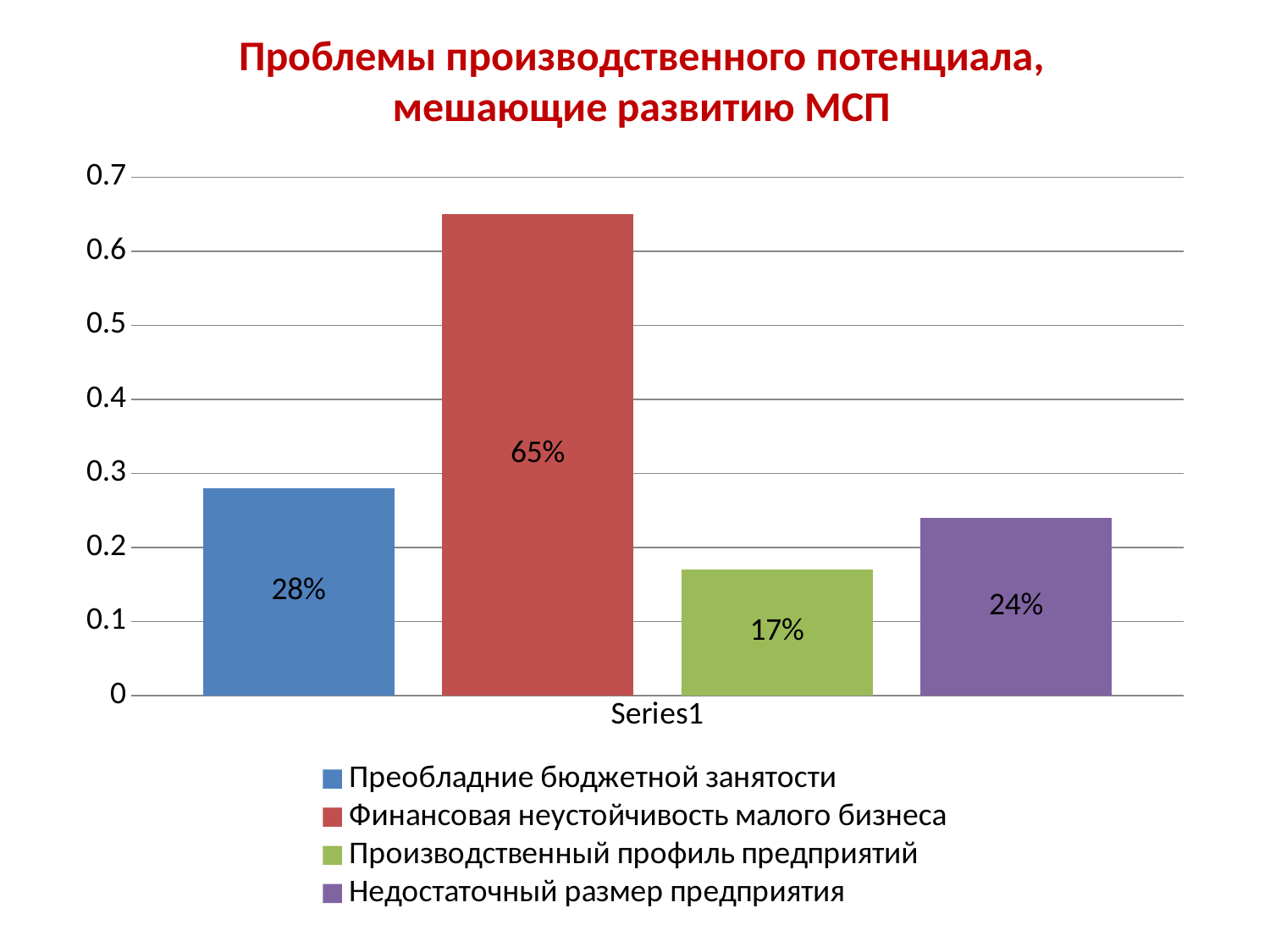
Which problem has the lowest value? Производственный профиль предприятий What is the value for Финансовая неустойчивость малого бизнеса? 65% What is the value for Преобладние бюджетной занятости? 28% Which is larger: the value for Преобладние бюджетной занятости or for Недостаточный размер предприятия? Преобладние бюджетной занятости Which problem has the highest value? Финансовая неустойчивость малого бизнеса What is the value for Производственный профиль предприятий? 17% What kind of chart is shown on the slide? bar chart How many bars are shown in the chart? 4 What is the value for Недостаточный размер предприятия? 24% Is the value for Финансовая неустойчивость малого бизнеса greater or less than 0.6? greater What is the difference between the values for Финансовая неустойчивость малого бизнеса and Преобладние бюджетной занятости? 37% How many entries does the legend list? 4